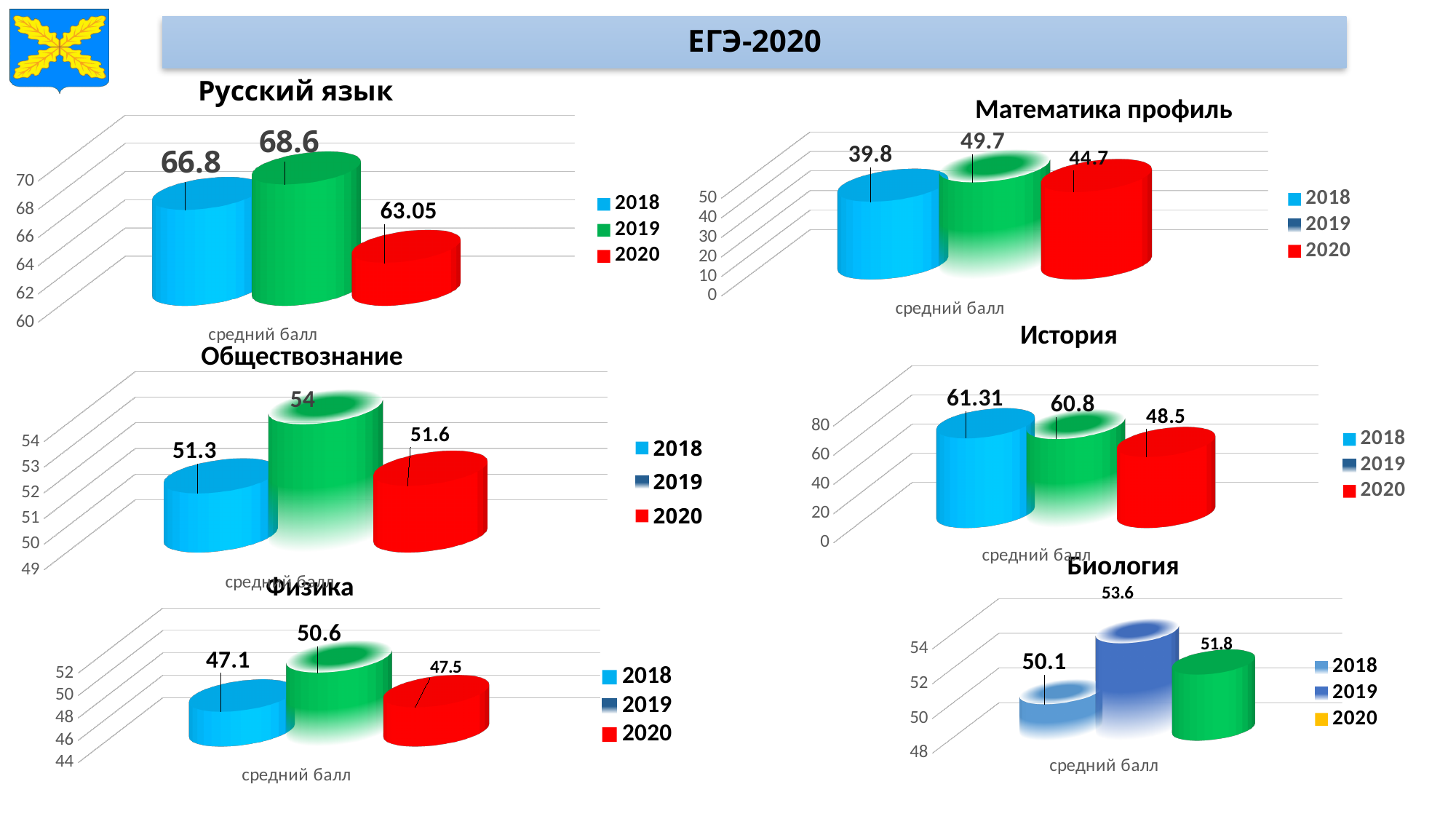
In the 'Биология' chart, what is the difference between the 2019 value and the 2018 value? 3.5 In the 'Русский язык' chart, what is the value for 2020? 63.05 In the 'Физика' chart, what is the value for 2019? 50.6 How many series does the legend of the 'История' chart list? 3 What kind of chart is the 'Физика' chart? bar chart In the 'История' chart, what is the difference between the 2018 value and the 2020 value? 12.81 In the 'Русский язык' chart, which year has the highest value? 2019 How many charts are shown on the slide? 6 In the 'Обществознание' chart, which is larger, the value for 2019 or the value for 2020? 2019 In the 'Математика профиль' chart, which year has the lowest value? 2018 In the 'Математика профиль' chart, what is the value for 2018? 39.8 In the 'История' chart, do the values rise or fall from 2018 to 2020? fall